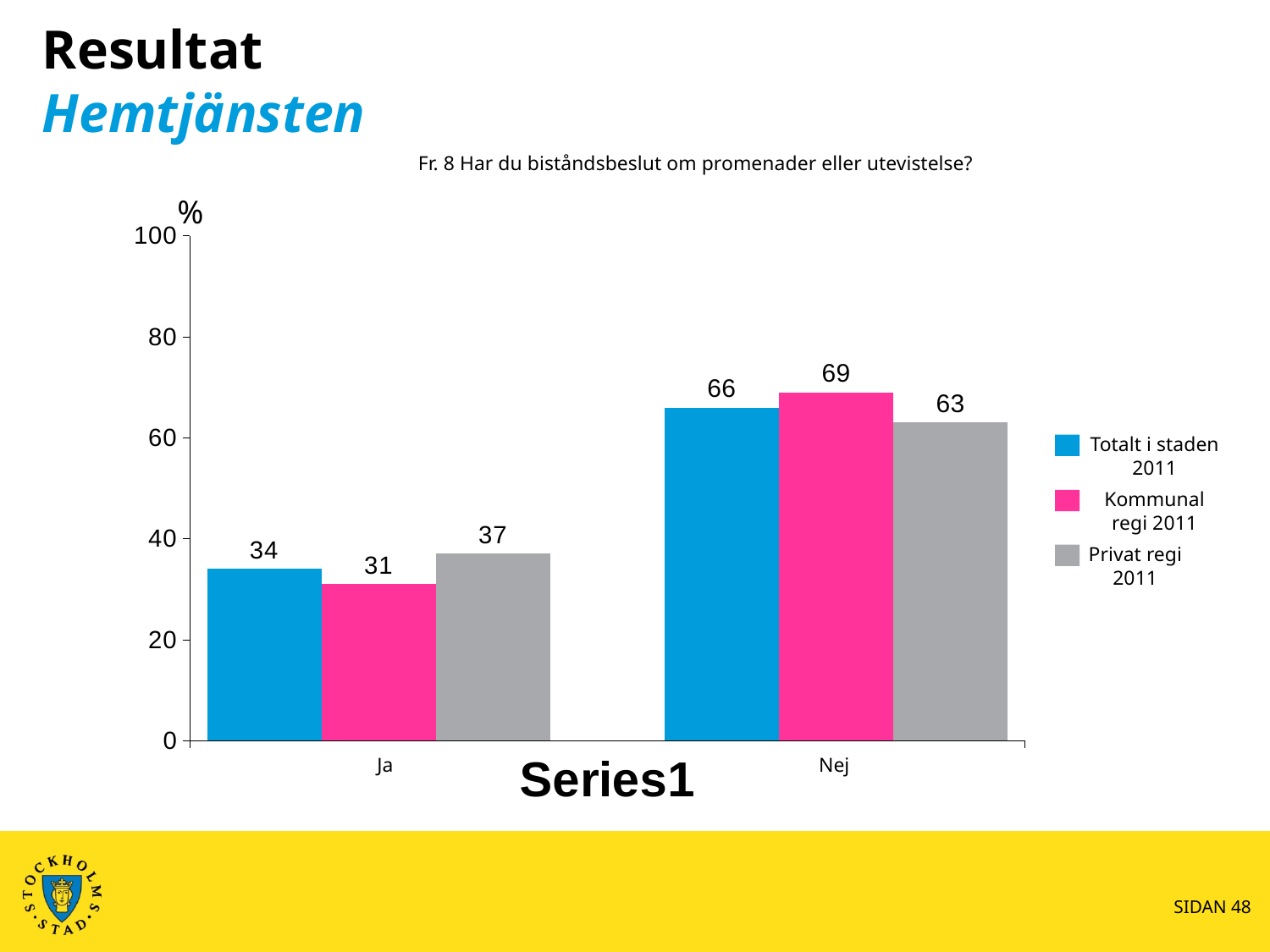
What is the value for Totalt i staden 2011 in the Ja category? 34 What is the value for Kommunal regi 2011 in the Nej category? 69 Which is larger: the Totalt i staden 2011 value for Ja or the Privat regi 2011 value for Ja? Privat regi 2011 value for Ja How many series does the legend list? 3 Which series has the highest value in the Nej category? Kommunal regi 2011 What kind of chart is shown on the slide? Bar chart What is the value for Privat regi 2011 in the Ja category? 37 What is the difference between the Kommunal regi 2011 and Privat regi 2011 values in the Nej category? 6 Which series has the lowest value in the Ja category? Kommunal regi 2011 Is the value for Totalt i staden 2011 in the Nej category greater or less than 60? greater What question is the chart about, as stated in its title? Fr. 8 Har du biståndsbeslut om promenader eller utevistelse? How many categories are shown on the x axis? 2